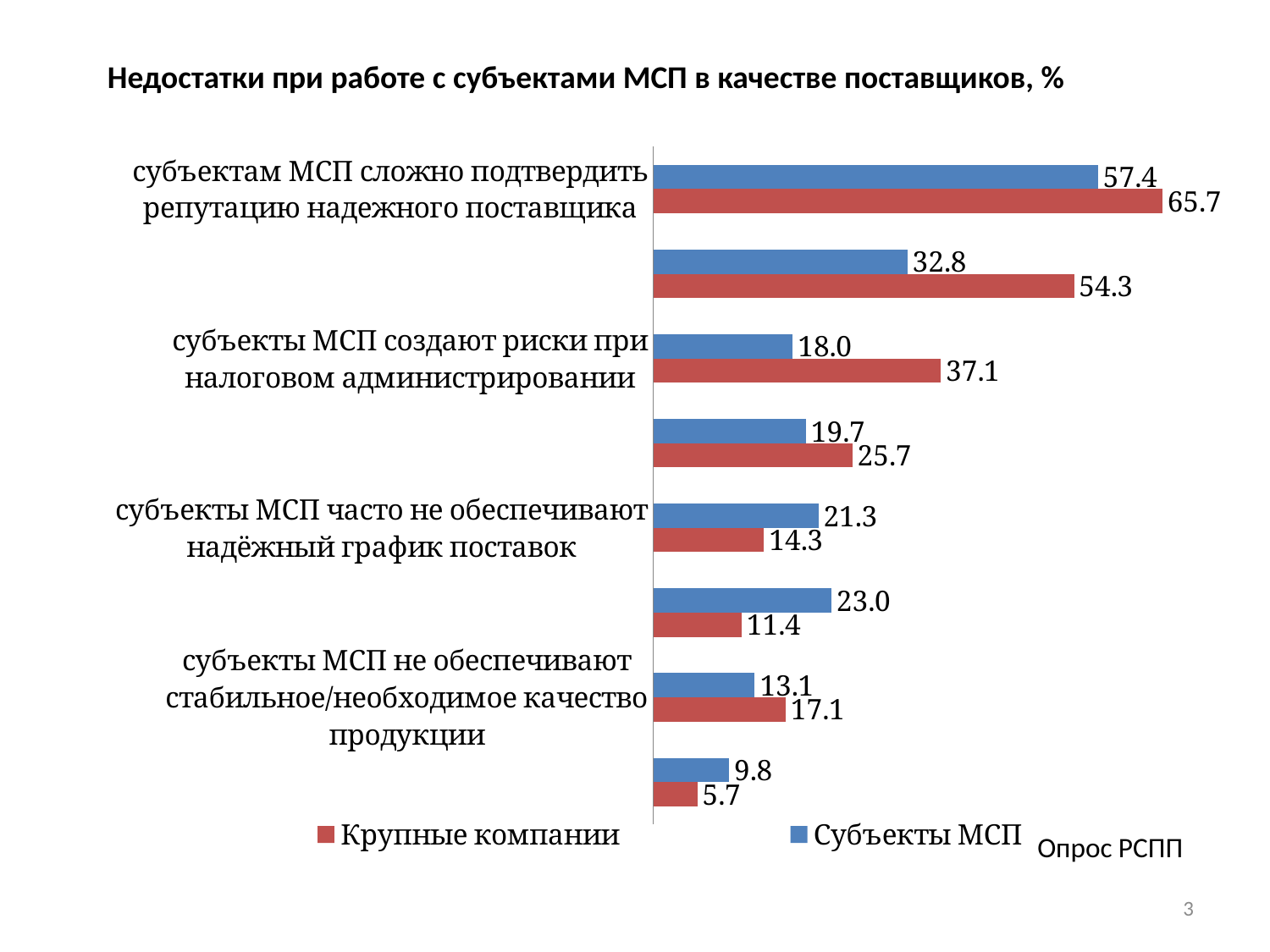
Which colour represents Крупные компании in the chart? Red What is the value for Субъекты МСП for the category 'субъекты МСП часто не обеспечивают надёжный график поставок'? 21.3 What is the difference between Крупные компании and Субъекты МСП for 'субъекты МСП создают риски при налоговом администрировании'? 19.1 What is the lowest value shown for Крупные компании? 5.7 What is the value for Крупные компании for the category 'субъекты МСП создают риски при налоговом администрировании'? 37.1 What is the value for Субъекты МСП for the category 'субъектам МСП сложно подтвердить репутацию надежного поставщика'? 57.4 For 'субъекты МСП часто не обеспечивают надёжный график поставок', which series has the larger value, Крупные компании or Субъекты МСП? Субъекты МСП What is the highest value shown on the chart? 65.7 What is the value for Крупные компании for the category 'субъектам МСП сложно подтвердить репутацию надежного поставщика'? 65.7 What is the value for Крупные компании for the category 'субъекты МСП не обеспечивают стабильное/необходимое качество продукции'? 17.1 What kind of chart is shown on the slide? Bar chart How many series does the legend list? 2